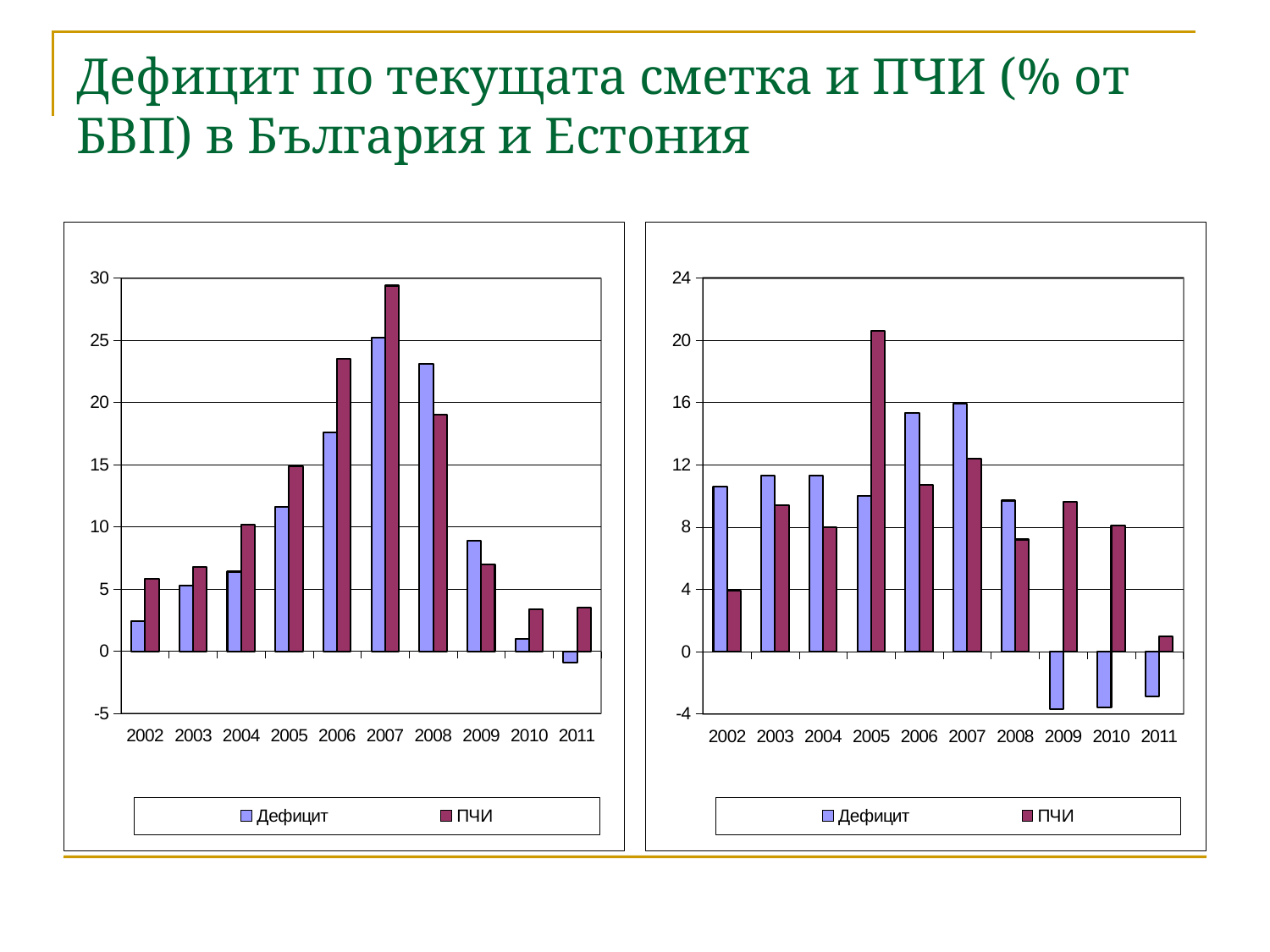
What kind of chart is the right chart? bar chart On the left chart, does the Дефицит series rise or fall from 2007 to 2011? fall On the right chart, in 2009, which is larger: Дефицит or ПЧИ? ПЧИ On the left chart, in 2008, which is larger: Дефицит or ПЧИ? Дефицит On the right chart, how many series does the legend list? 2 On the right chart, is the ПЧИ value for 2005 greater or less than 20? greater On the left chart, is the Дефицит value for 2005 greater or less than 10? greater On the right chart, which year has the highest ПЧИ value? 2005 On the left chart, how many years are shown on the x axis? 10 On the left chart, which year has the lowest Дефицит value? 2011 On the left chart, is the ПЧИ value for 2007 greater or less than 25? greater On the left chart, which year has the highest ПЧИ value? 2007